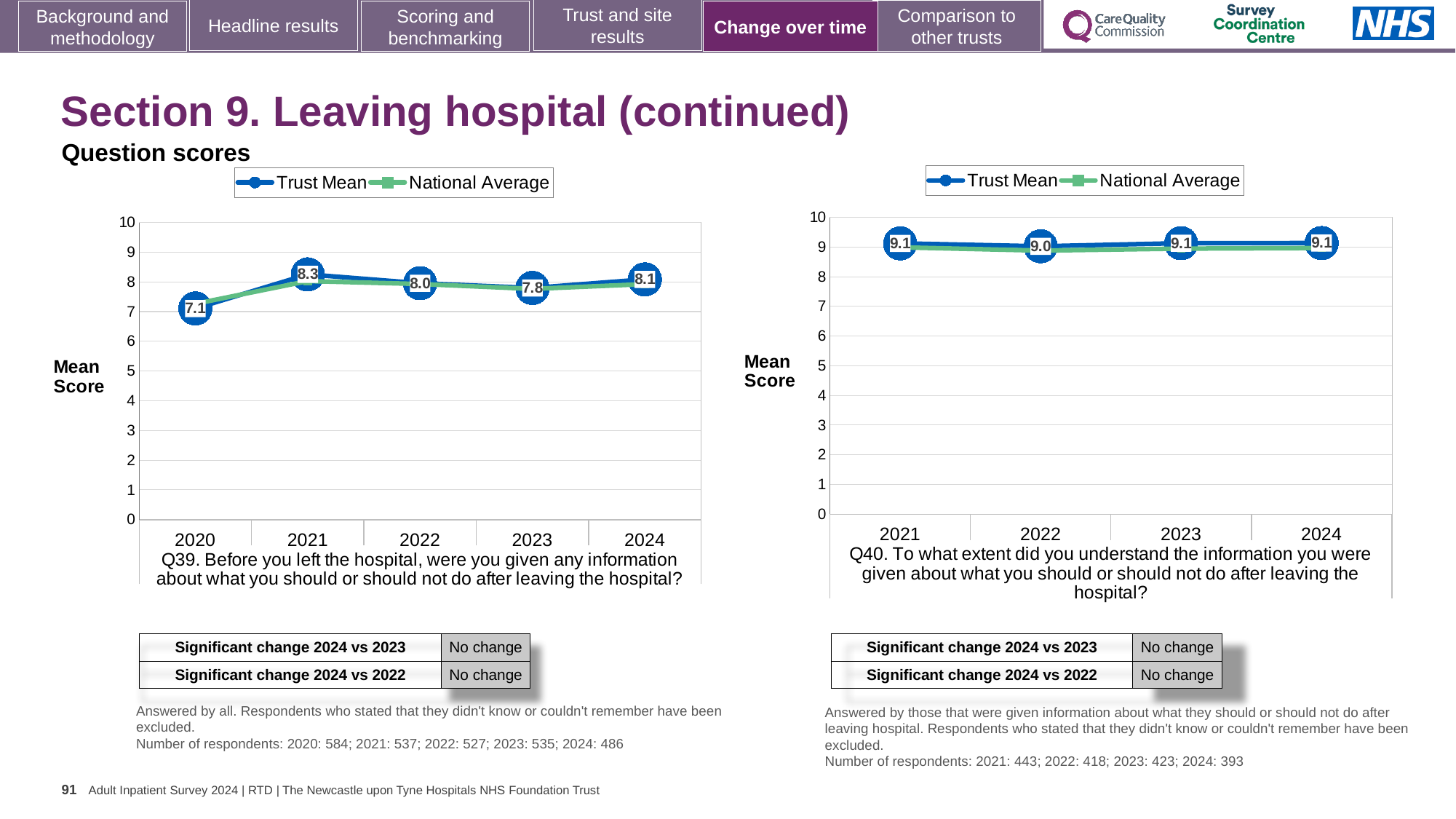
What type of chart is the Q39 chart on the left? Line chart How many years are plotted in the Q40 chart on the right? 4 In the Q40 chart on the right, what is the Trust Mean score for 2022? 9.0 In the Q40 chart on the right, is the National Average value for 2021 greater or less than 5? greater In the Q39 chart on the left, what is the Trust Mean score for 2020? 7.1 In the Q39 chart on the left, which year has the lowest Trust Mean score? 2020 In the Q39 chart on the left, is the Trust Mean score higher in 2023 or 2024? 2024 How many series does the legend of the Q39 chart on the left list? 2 In the Q40 chart on the right, which year has the lowest Trust Mean score? 2022 In the Q39 chart on the left, what is the difference between the Trust Mean scores for 2021 and 2020? 1.2 In the Q39 chart on the left, what is the Trust Mean score for 2024? 8.1 In the Q39 chart on the left, which year has the highest Trust Mean score? 2021